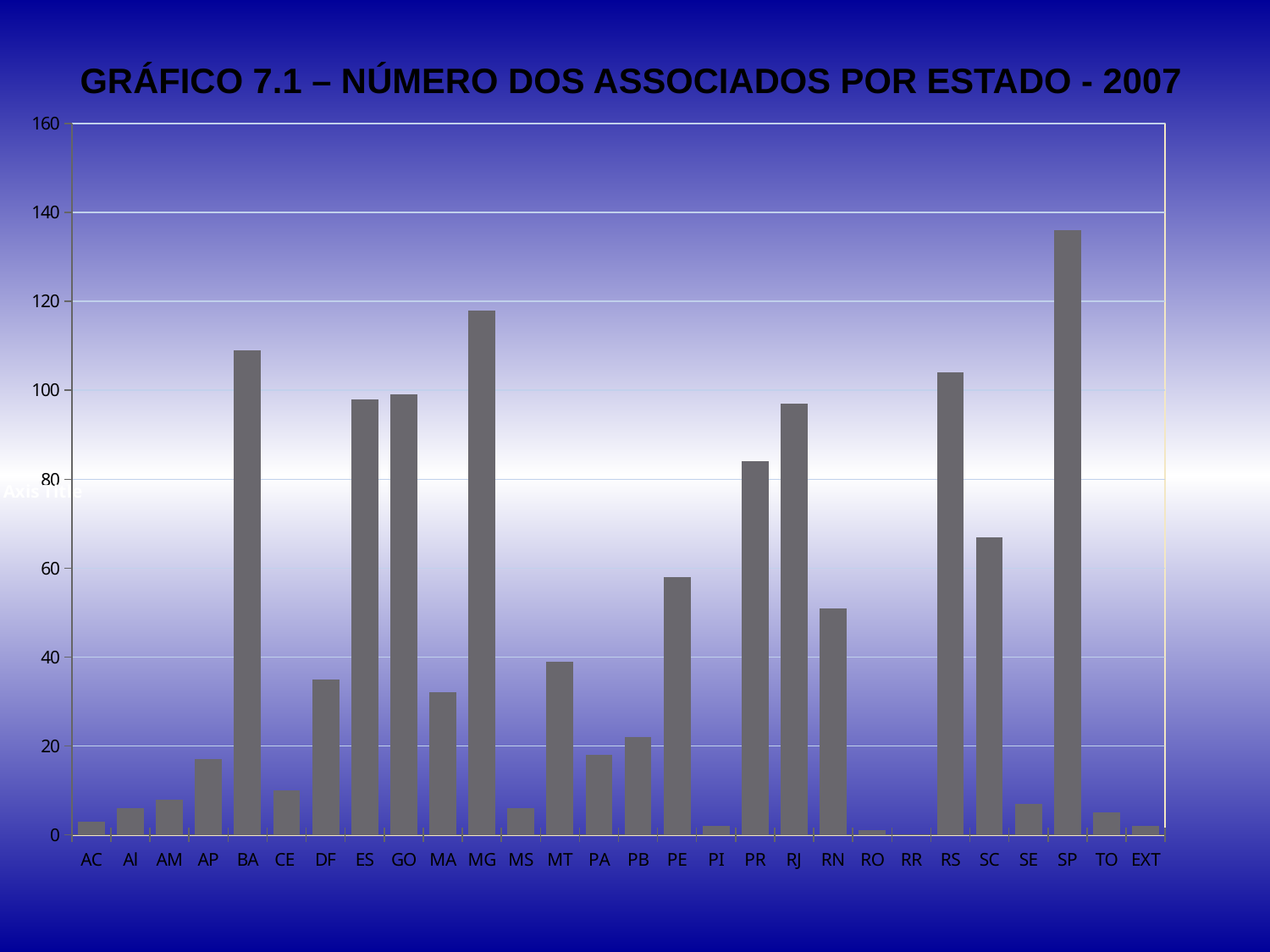
Is the value for DF greater or less than 40? less Which state has the highest number of associados in the chart? SP Is the value for SP greater or less than 120? greater Which is larger, the value for PR or the value for RJ? RJ How many categories are shown on the x axis? 28 Which state has the lowest number of associados in the chart? RR Which is larger, the value for SP or the value for MG? SP Is the value for RN greater or less than 40? greater What is the title of the chart? GRÁFICO 7.1 – NÚMERO DOS ASSOCIADOS POR ESTADO - 2007 What kind of chart is shown on the slide? bar chart